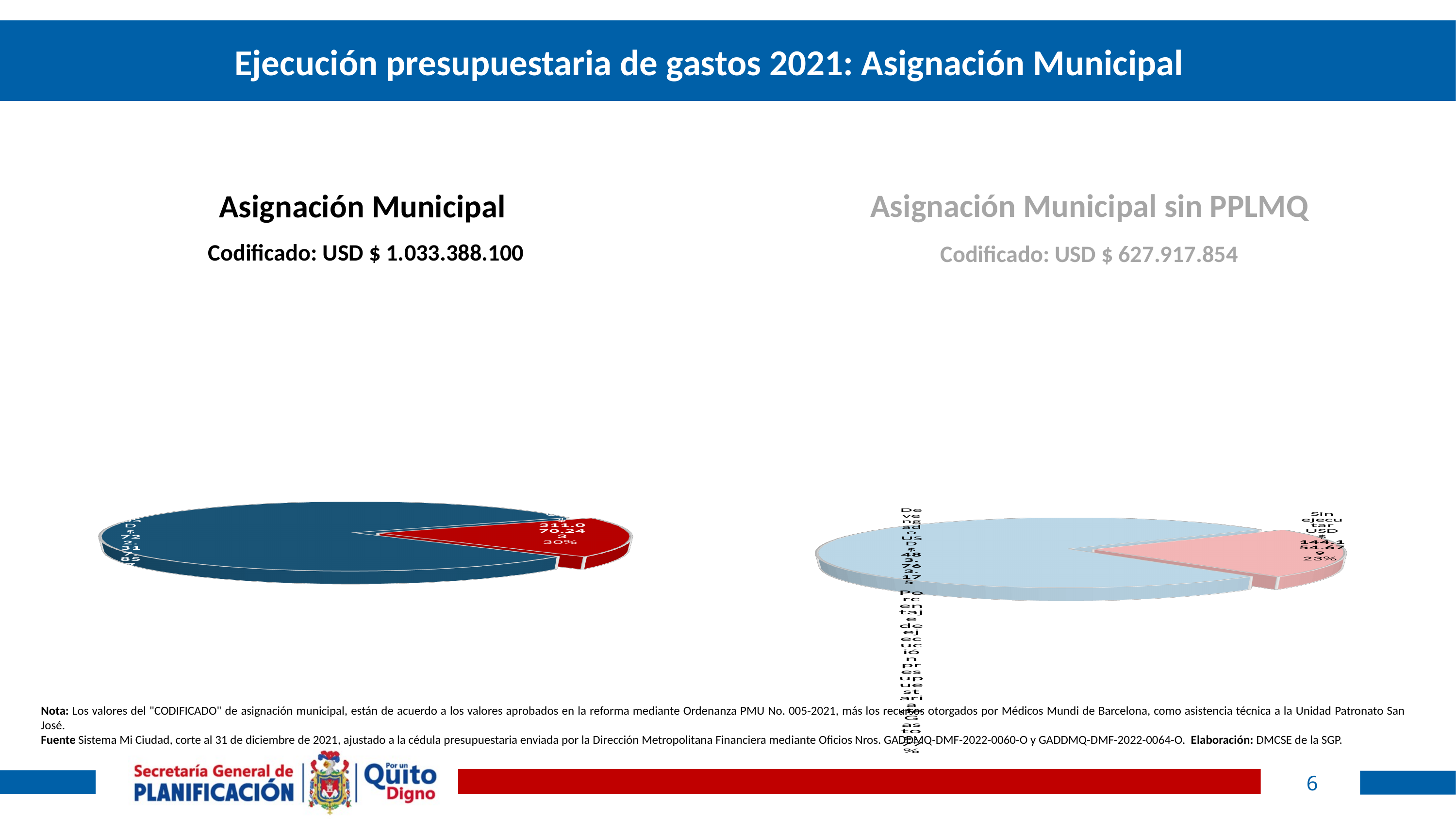
In the 'Asignación Municipal sin PPLMQ' pie chart on the right, what is the value of the 'Sin ejecutar' slice? USD $ 144.154.679 In the 'Asignación Municipal sin PPLMQ' pie chart on the right, what share of the pie does the 'Sin ejecutar' slice represent? 23% What kind of chart is the 'Asignación Municipal sin PPLMQ' chart on the right? Pie chart What kind of chart is the 'Asignación Municipal' chart on the left? Pie chart In the 'Asignación Municipal sin PPLMQ' pie chart on the right, which slice is smaller, the light blue one or the pink 'Sin ejecutar' one? The pink 'Sin ejecutar' one In the 'Asignación Municipal' pie chart on the left, which slice is larger, the dark blue one or the red one? The dark blue one In the 'Asignación Municipal' pie chart on the left, how many slices are there? 2 What is the 'Codificado' amount shown above the 'Asignación Municipal' chart on the left? USD $ 1.033.388.100 In the 'Asignación Municipal sin PPLMQ' pie chart on the right, how many slices are there? 2 In the 'Asignación Municipal' pie chart on the left, what share of the pie does the red slice represent? 30% In the 'Asignación Municipal' pie chart on the left, what is the value printed on the red slice? 311.070.243 What is the 'Codificado' amount shown above the 'Asignación Municipal sin PPLMQ' chart on the right? USD $ 627.917.854